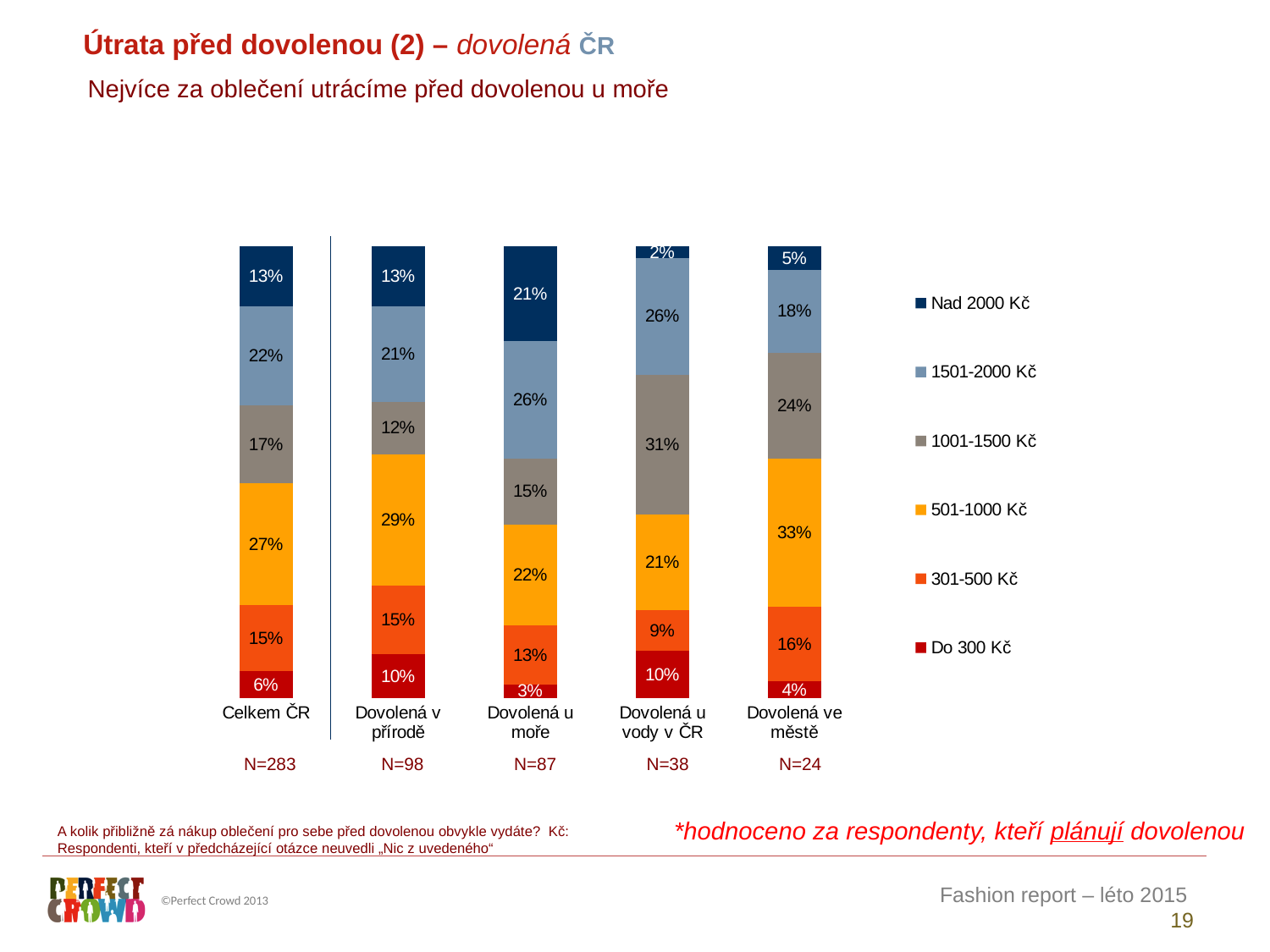
What is the difference between the '501-1000 Kč' values for 'Dovolená ve městě' and 'Celkem ČR'? 6% What kind of chart is shown on the slide? Stacked bar chart What is the value of the '501-1000 Kč' segment for 'Dovolená ve městě'? 33% What is the value of the '1001-1500 Kč' segment for 'Dovolená u vody v ČR'? 31% What share of respondents in the 'Dovolená u moře' category spend 'Nad 2000 Kč'? 21% How many categories are shown on the x axis of the chart? 5 What is the value of the 'Do 300 Kč' segment for 'Celkem ČR'? 6% What is the sample size (N) shown for the 'Dovolená u vody v ČR' category? N=38 Which category has the highest value for the 'Nad 2000 Kč' series? Dovolená u moře Which category has the lowest value for the 'Do 300 Kč' series? Dovolená u moře Which is larger: the '1501-2000 Kč' value for 'Dovolená u moře' or for 'Dovolená v přírodě'? Dovolená u moře How many series does the legend list? 6